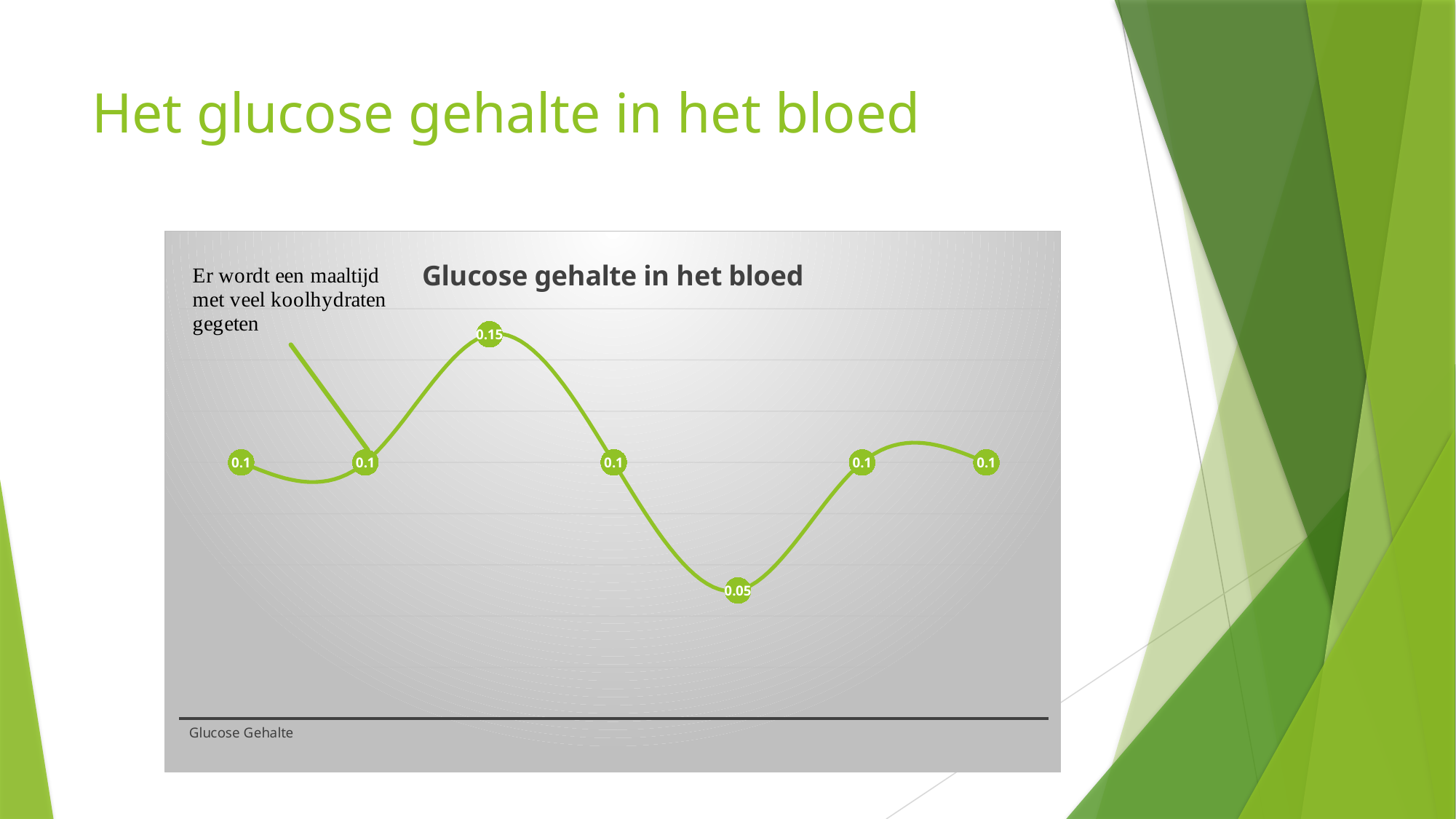
Which is larger, the third data point or the fifth data point? the third data point What series name is shown at the bottom of the chart? Glucose Gehalte What is the value of the fifth data point from the left? 0.05 How many data points are plotted on the line? 7 Does the line rise or fall between the second and third data points? rise What kind of chart is shown on the slide? line chart What is the value of the first data point on the left? 0.1 What is the lowest value plotted on the chart? 0.05 What is the highest value plotted on the chart? 0.15 What is the title of the chart? Glucose gehalte in het bloed What is the value of the third data point from the left? 0.15 What is the difference between the highest and lowest plotted values? 0.1